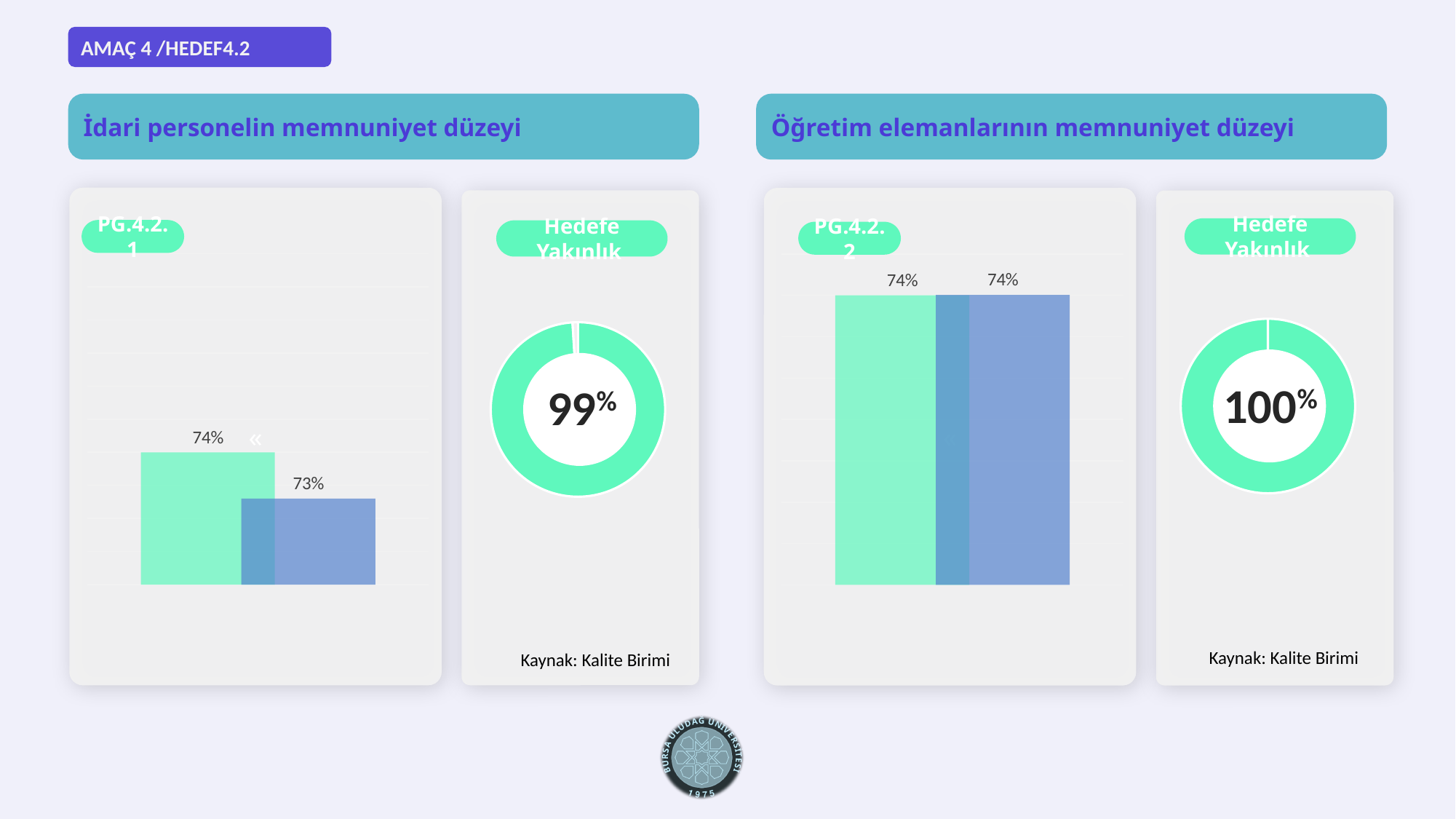
In the PG.4.2.1 bar chart, which bar is higher, the green one or the blue one? the green bar Which 'Hedefe Yakınlık' donut chart shows the higher value, the one on the left or the one on the right? the one on the right In the PG.4.2.1 bar chart, what is the difference between the green bar and the blue bar? 1% What percentage is shown in the 'Hedefe Yakınlık' donut chart under 'İdari personelin memnuniyet düzeyi'? 99% How many bars are plotted in the PG.4.2.2 bar chart? 2 In the PG.4.2.1 bar chart under 'İdari personelin memnuniyet düzeyi', what value is shown on the blue bar? 73% In the PG.4.2.1 bar chart under 'İdari personelin memnuniyet düzeyi', what value is shown on the green bar? 74% What percentage is shown in the 'Hedefe Yakınlık' donut chart under 'Öğretim elemanlarının memnuniyet düzeyi'? 100% In the PG.4.2.2 bar chart under 'Öğretim elemanlarının memnuniyet düzeyi', what value is shown on the green bar? 74% What source is cited below the 'Hedefe Yakınlık' donut charts? Kaynak: Kalite Birimi In the PG.4.2.2 bar chart under 'Öğretim elemanlarının memnuniyet düzeyi', what value is shown on the blue bar? 74% What kind of chart is the PG.4.2.1 chart? bar chart